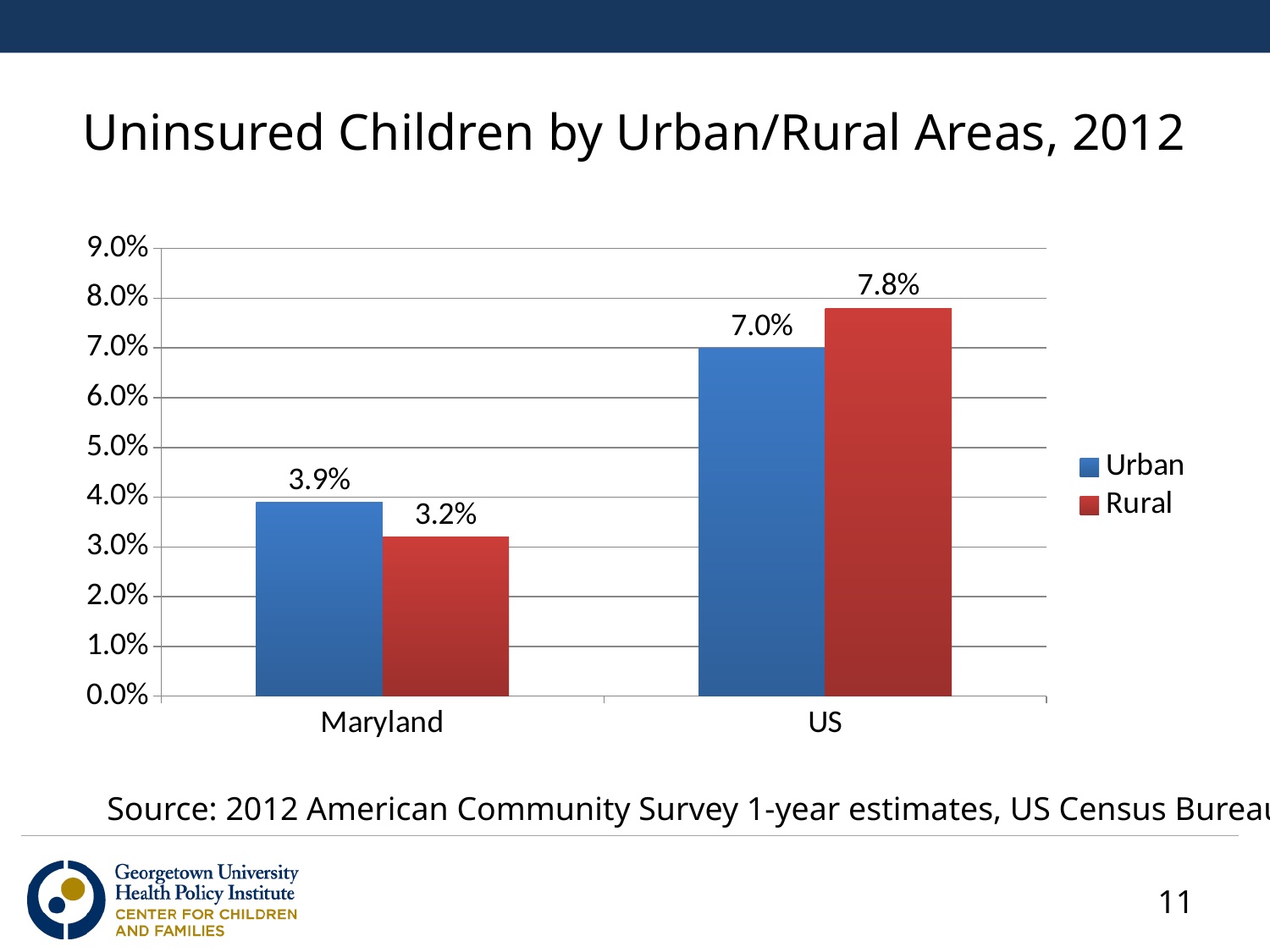
What is the difference between the Rural and Urban values for US? 0.8% How many series does the legend list? 2 What is the Rural value for US? 7.8% What kind of chart is shown on the slide? Bar chart What is the difference between the Urban and Rural values for Maryland? 0.7% Which bar has the lowest value on the chart? Maryland Rural Which is larger for Maryland, the Urban value or the Rural value? Urban What is the Urban value for US? 7.0% How many categories are shown on the x axis? 2 Which bar has the highest value on the chart? US Rural What is the Rural value for Maryland? 3.2% What is the Urban value for Maryland? 3.9%